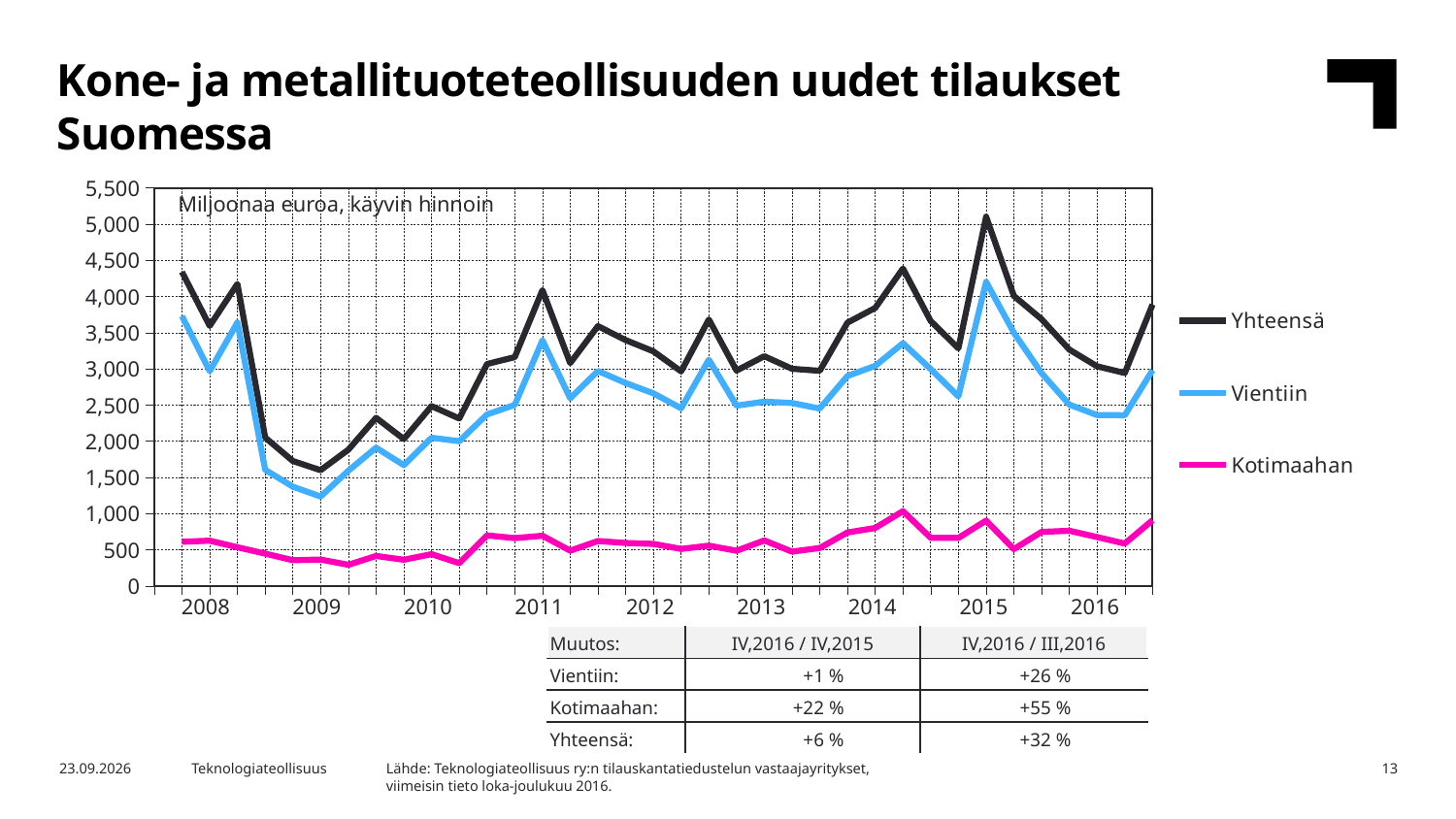
Is the value for Kotimaahan in 2009 greater or less than 1,000? less What kind of chart is shown on the slide? line chart Is the lowest value for Vientiin in 2009 greater or less than 1,500? less Is the peak value of Yhteensä in 2015 greater or less than 5,000? greater How many years are labelled on the x axis? 9 Which series has the lowest values throughout the chart? Kotimaahan Which series is shown with the pink line? Kotimaahan Which series has the highest values throughout the chart? Yhteensä How many series does the legend list? 3 In 2015, which is larger, Vientiin or Kotimaahan? Vientiin Did the Yhteensä series rise or fall from the start of 2008 to the start of 2009? fall What unit label is printed inside the chart area? Miljoonaa euroa, käyvin hinnoin